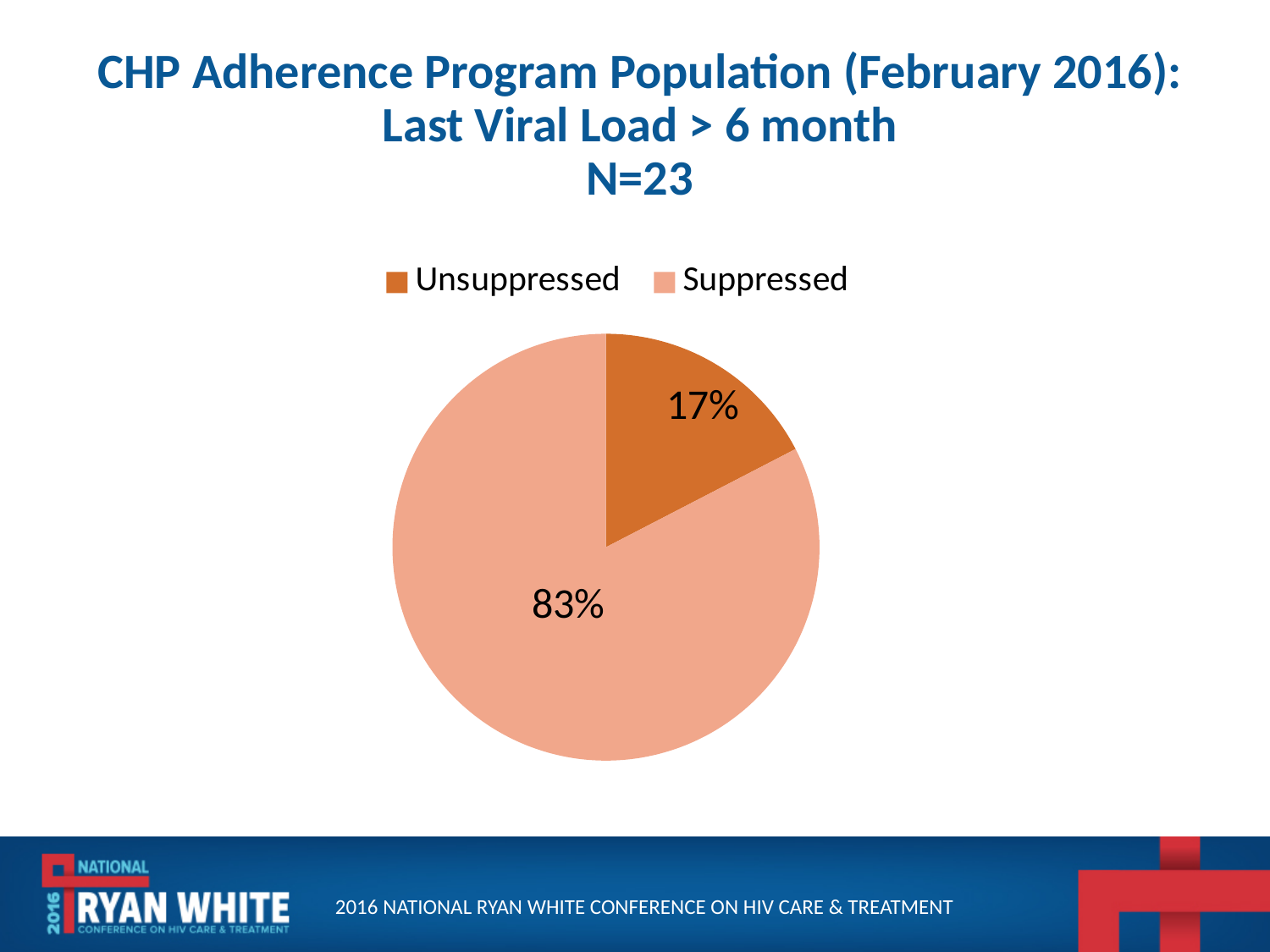
How many slices does the pie chart have? 2 What is the share of the pie taken by the Suppressed slice? 83% What percentage of the pie is Unsuppressed? 17% What kind of chart is shown on the slide? pie chart Which legend entry is shown in the darker orange colour? Unsuppressed What is the N value stated in the chart title? N=23 Which slice is larger, Suppressed or Unsuppressed? Suppressed How many entries does the legend list? 2 What is the difference in percentage points between the Suppressed and Unsuppressed slices? 66 Which category has the largest share of the pie? Suppressed What percentage of the pie is Suppressed? 83% Which category has the smallest share of the pie? Unsuppressed